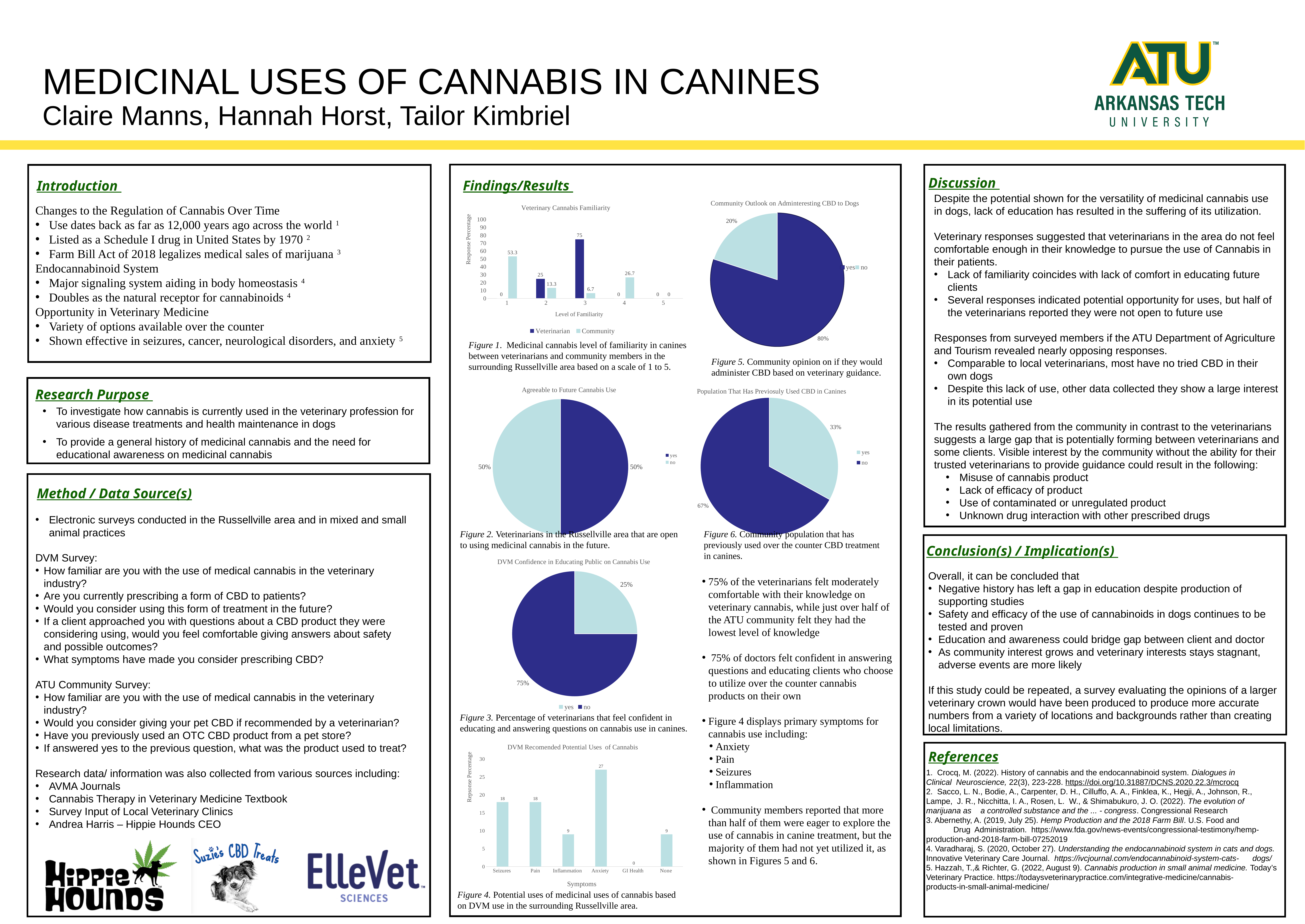
In the 'Veterinary Cannabis Familiarity' chart, what is the Veterinarian value at familiarity level 3? 75 In the 'Veterinary Cannabis Familiarity' chart, what is the Community value at familiarity level 1? 53.3 In the 'Population That Has Previosuly Used CBD in Canines' pie chart, what share of responses is 'no'? 67% In the 'DVM Confidence in Educating Public on Cannabis Use' pie chart, what share of responses is 'yes'? 25% In the 'DVM Recomended Potential Uses of Cannabis' chart, which symptom has the highest value? Anxiety In the 'DVM Recomended Potential Uses of Cannabis' chart, what is the value for Inflammation? 9 In the 'Agreeable to Future Cannabis Use' pie chart, what share of responses is 'yes'? 50% In the 'DVM Recomended Potential Uses of Cannabis' chart, how many symptom categories are shown on the x axis? 6 In the 'Veterinary Cannabis Familiarity' chart, at level 2, which series has the larger value, Veterinarian or Community? Veterinarian In the 'Veterinary Cannabis Familiarity' chart, what is the difference between the Community values at level 1 and level 4? 26.6 In the 'Veterinary Cannabis Familiarity' chart, how many series does the legend list? 2